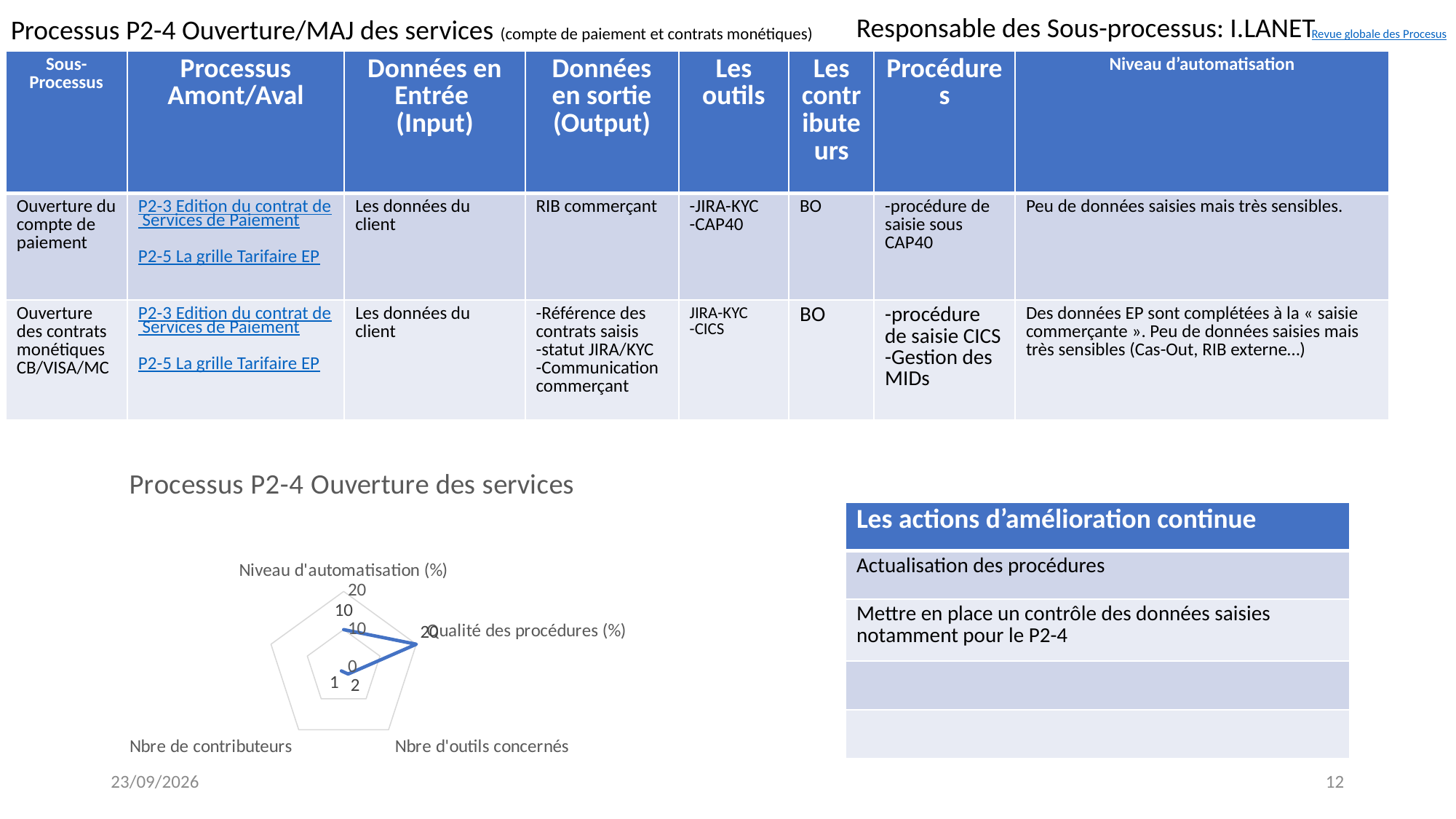
What is the value for Niveau d'automatisation (%) in the radar chart? 10 What is the maximum value shown on the radar chart's axis scale? 20 What kind of chart is shown under the title "Processus P2-4 Ouverture des services"? Radar chart Which axis has the highest value in the radar chart? Qualité des procédures (%) What is the difference between the values for Qualité des procédures (%) and Niveau d'automatisation (%)? 10 What is the value for Qualité des procédures (%) in the radar chart? 20 What is the value for Nbre de contributeurs in the radar chart? 1 What is the value for Nbre d'outils concernés in the radar chart? 2 What is the title of the chart on the slide? Processus P2-4 Ouverture des services Which is larger in the radar chart: Nbre d'outils concernés or Nbre de contributeurs? Nbre d'outils concernés Is the value for Nbre de contributeurs greater or less than 10? less